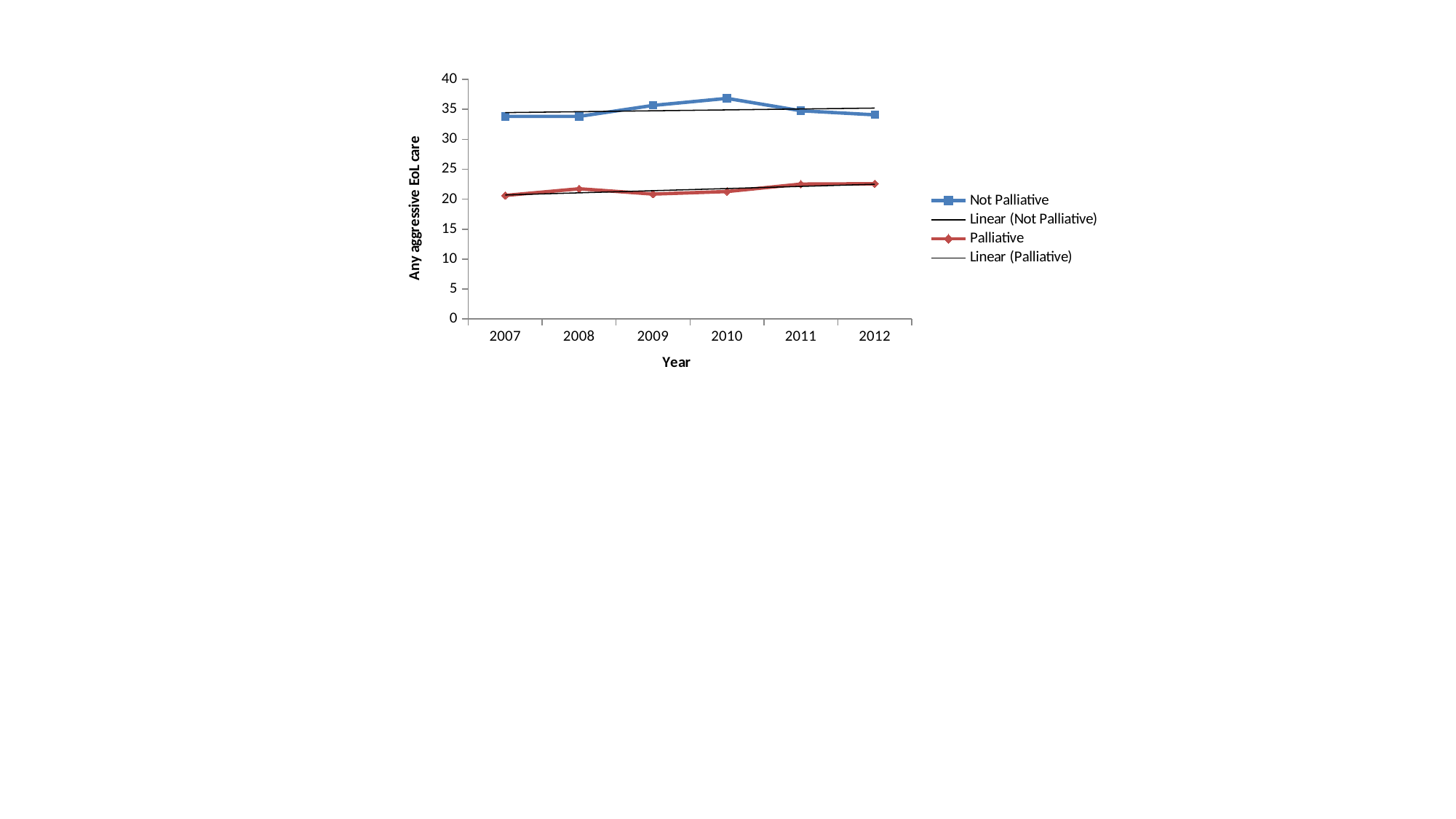
Which series has the higher value in 2010, Not Palliative or Palliative? Not Palliative How many entries does the legend list? 4 In which year does the Not Palliative series reach its highest value? 2010 Does the Palliative series generally rise or fall from 2007 to 2012? Rise Is the value for Palliative in 2012 greater or less than 25? less What colour is the Palliative series line? Red Is the value for Not Palliative in 2010 greater or less than 35? greater What kind of chart is shown on the slide? Line chart How many years are plotted along the x axis? 6 Is the value for Not Palliative in 2007 greater or less than 30? greater What is the title of the y axis? Any aggressive EoL care